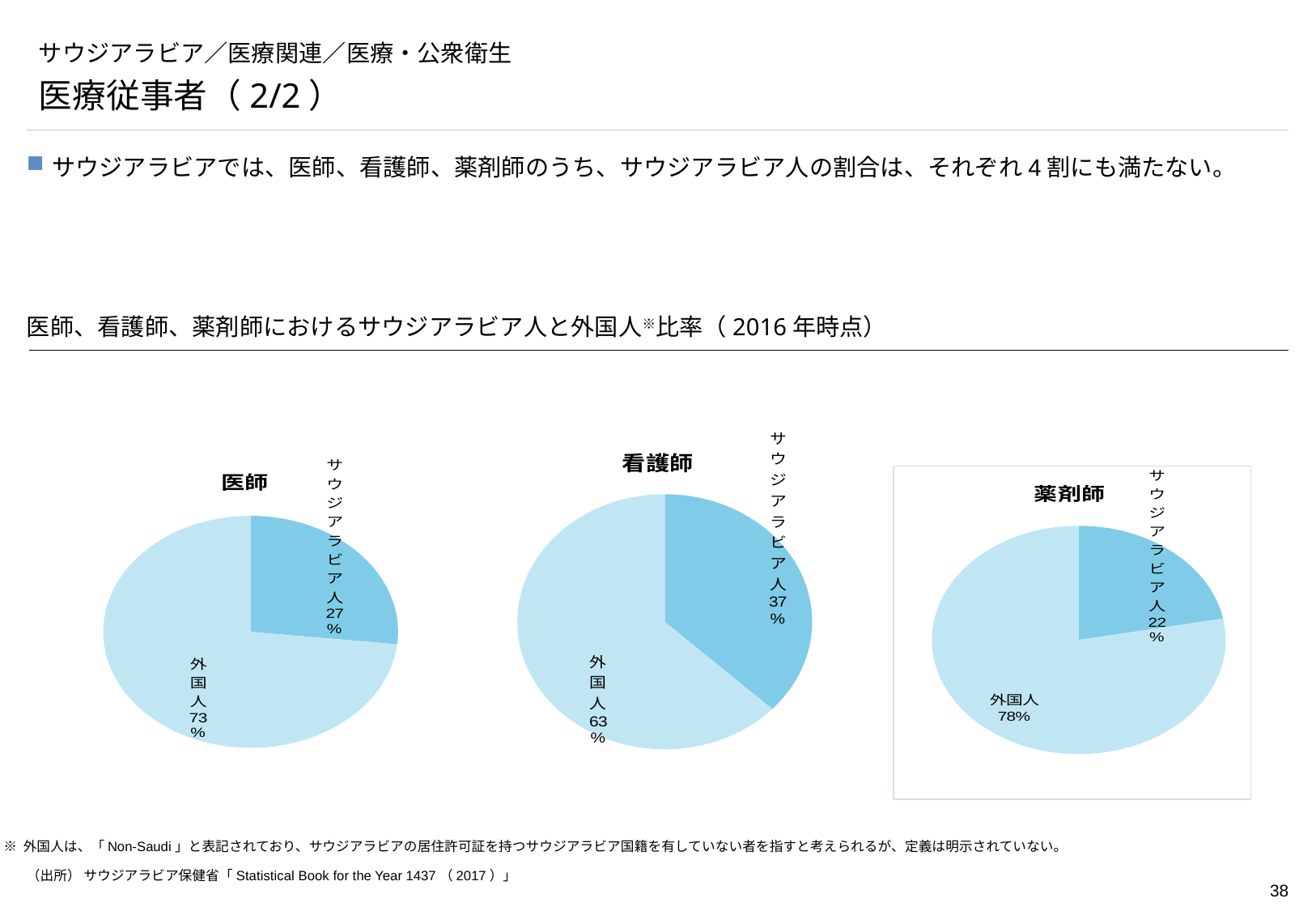
In the 薬剤師 pie chart, which slice is larger, サウジアラビア人 or 外国人? 外国人 In the 医師 pie chart, what share is labelled for 外国人? 73% In the 医師 pie chart, what share is labelled for サウジアラビア人? 27% Across the three pie charts, which profession has the lowest share of サウジアラビア人? 薬剤師 In the 薬剤師 pie chart, what share is labelled for 外国人? 78% What kind of chart is the 医師 chart? Pie chart In the 看護師 pie chart, what share is labelled for サウジアラビア人? 37% In the 医師 pie chart, what is the difference between the 外国人 share and the サウジアラビア人 share? 46% In the 薬剤師 pie chart, what share is labelled for サウジアラビア人? 22% In the 看護師 pie chart, what share is labelled for 外国人? 63% How many slices does the 看護師 pie chart have? 2 Across the three pie charts, which profession has the highest share of サウジアラビア人? 看護師